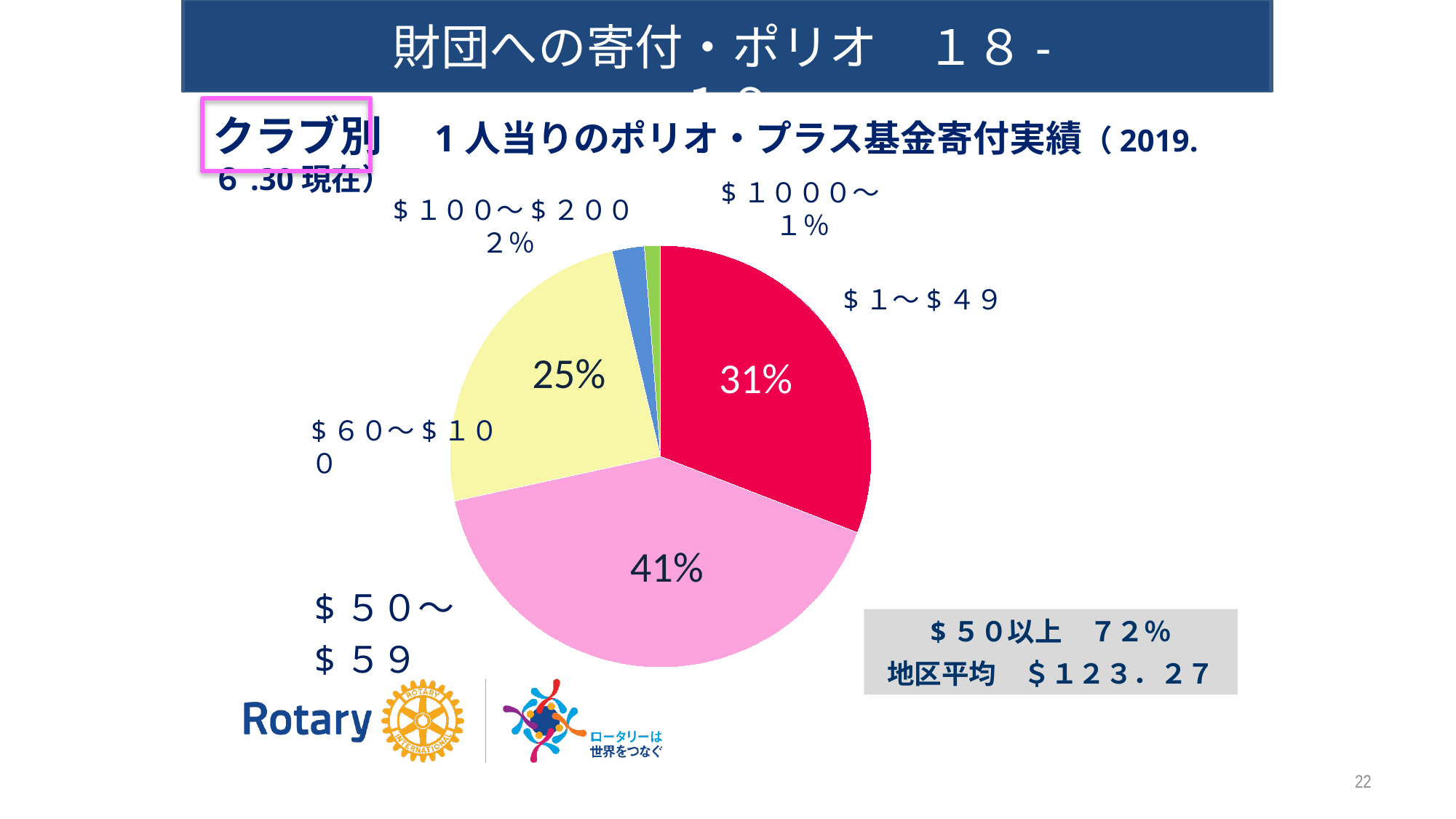
What share of the pie does the $50～$59 slice represent? 41% What share of the pie does the $100～$200 slice represent? 2% What share of the pie does the $1～$49 slice represent? 31% How many slices does the pie chart have? 5 Which category has the smallest slice of the pie? $1000～ What is the difference in percentage points between the $50～$59 slice and the $1～$49 slice? 10 Which slice is larger, $1～$49 or $60～$100? $1～$49 What kind of chart is shown on the slide? pie chart Which category has the largest slice of the pie? $50～$59 What colour is the $50～$59 slice of the pie? pink